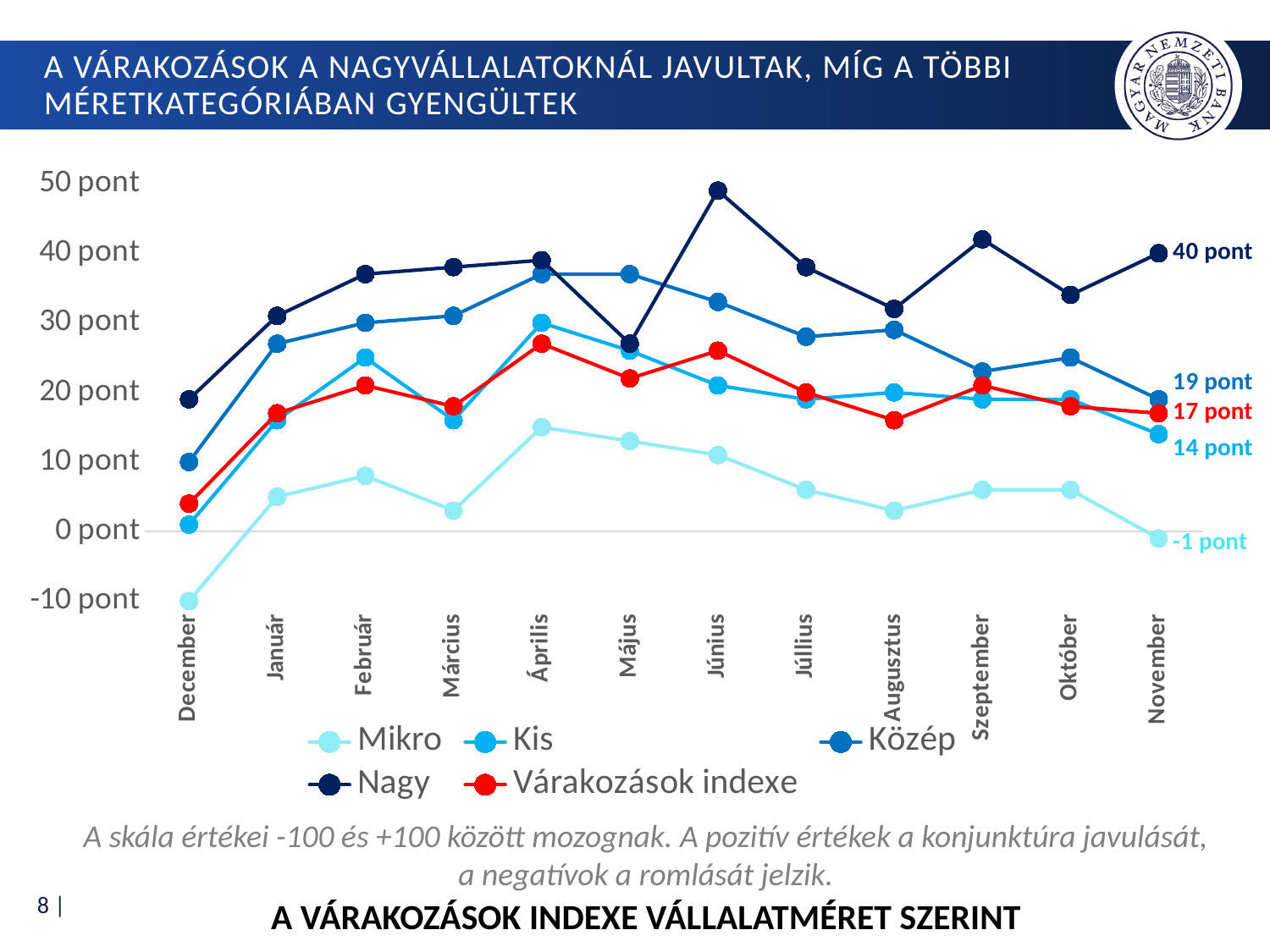
What is the value of the Mikro series in November? -1 pont Which series has the highest value in November? Nagy In November, how much higher is the Nagy value than the Közép value? 21 pont What is the value of the Várakozások indexe series in November? 17 pont Is the value for the Nagy series in Június greater or less than 40 pont? greater How many months are shown on the x axis? 12 What is the value of the Kis series in November? 14 pont What kind of chart is shown on the slide? line chart How many series does the legend list? 5 What is the value of the Közép series in November? 19 pont In November, which is larger: the Kis value or the Közép value? Közép What is the value of the Nagy series in November? 40 pont